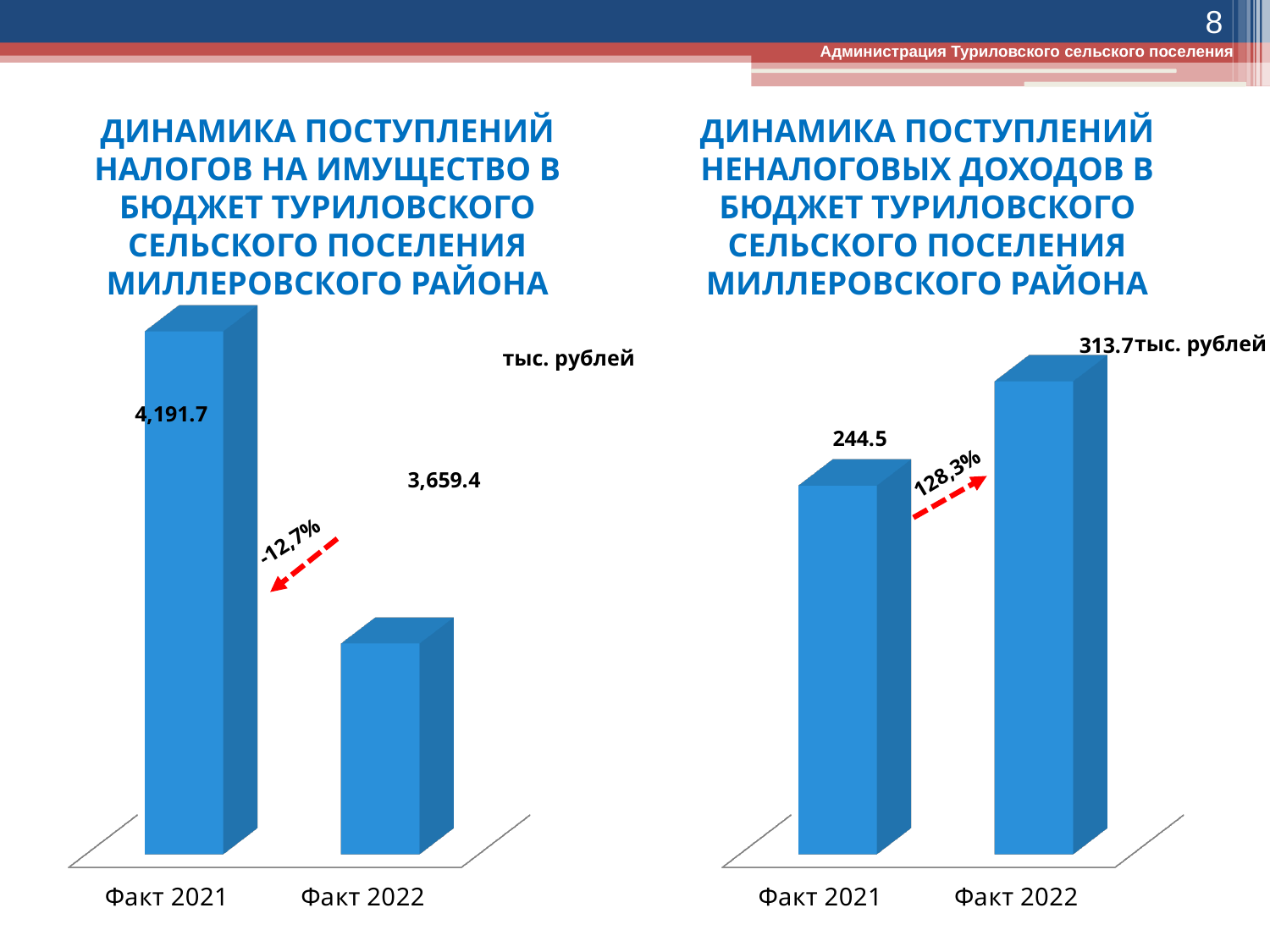
On the right chart (non-tax revenues), what is the value for Факт 2021? 244.5 On the right chart (non-tax revenues), what is the value for Факт 2022? 313.7 On the left chart (property taxes), what is the value for Факт 2022? 3,659.4 On the left chart (property taxes), do the values rise or fall from Факт 2021 to Факт 2022? fall On the left chart (property taxes), what is the value for Факт 2021? 4,191.7 On the left chart (property taxes), which category has the higher value? Факт 2021 On the right chart (non-tax revenues), what is the difference between the Факт 2022 and Факт 2021 values? 69.2 On the right chart (non-tax revenues), do the values rise or fall from Факт 2021 to Факт 2022? rise On the left chart (property taxes), what is the difference between the Факт 2021 and Факт 2022 values? 532.3 On the right chart (non-tax revenues), which category has the lower value? Факт 2021 What percentage change is shown by the arrow on the left chart (property taxes)? -12,7% What kind of chart is the left chart (property taxes)? bar chart